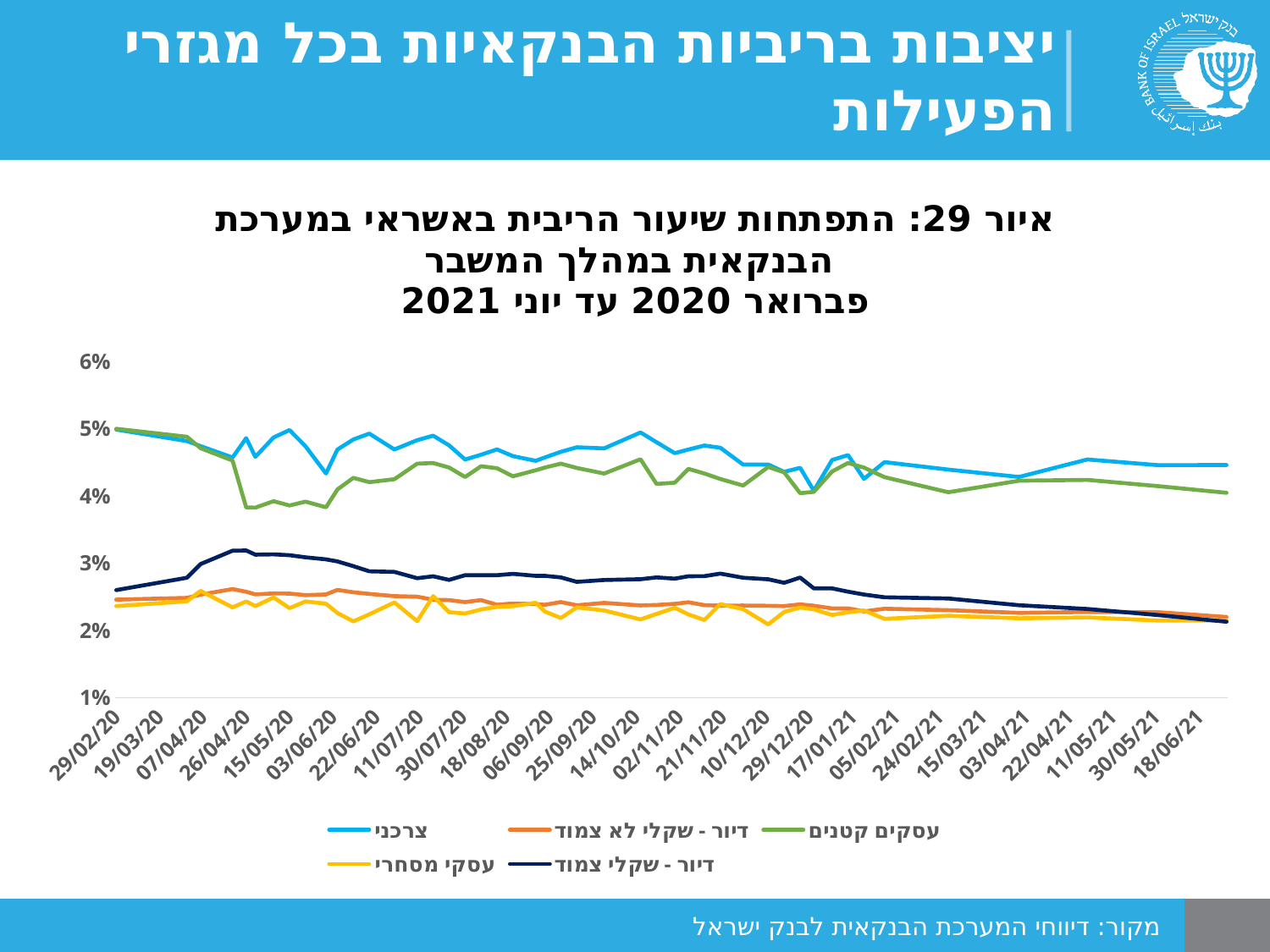
Is the value for דיור - שקלי צמוד at 18/06/21 greater or less than 3%? less Is the value for עסקים קטנים at 26/04/20 greater or less than 4%? less What kind of chart is shown on the slide? line chart Which figure number is given in the chart title? איור 29 At 18/06/21, which is larger: צרכני or עסקים קטנים? צרכני Does the דיור - שקלי צמוד series rise or fall from 26/04/20 to 18/06/21? fall Which series has the highest value at 18/06/21? צרכני Is the value for צרכני at 18/06/21 greater or less than 4%? greater How many series does the legend list? 5 At 26/04/20, which is larger: דיור - שקלי צמוד or דיור - שקלי לא צמוד? דיור - שקלי צמוד What is the highest value shown on the vertical axis? 6%